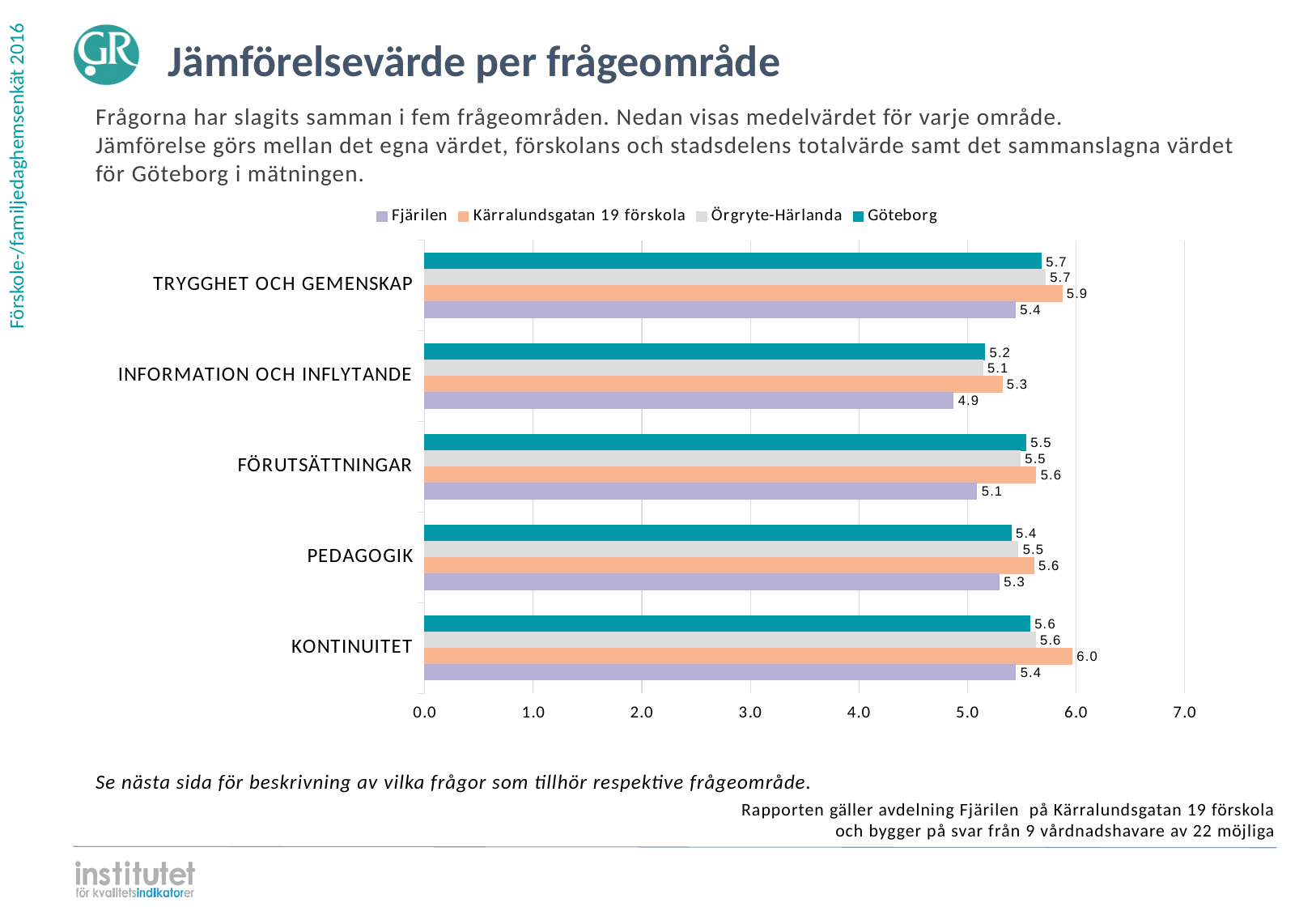
What is the value for Kärralundsgatan 19 förskola in the KONTINUITET category? 6.0 How many categories are shown on the chart? 5 What is the value for Göteborg in the PEDAGOGIK category? 5.4 What is the difference between the Kärralundsgatan 19 förskola value and the Fjärilen value in the TRYGGHET OCH GEMENSKAP category? 0.5 What kind of chart is shown on the slide? Bar chart In which category does Fjärilen have its lowest value? INFORMATION OCH INFLYTANDE How many series does the legend list? 4 In which category does Kärralundsgatan 19 förskola have its highest value? KONTINUITET What is the value for Örgryte-Härlanda in the FÖRUTSÄTTNINGAR category? 5.5 What is the value for Fjärilen in the INFORMATION OCH INFLYTANDE category? 4.9 What is the title of the slide? Jämförelsevärde per frågeområde Which is larger in the PEDAGOGIK category: the value for Fjärilen or the value for Örgryte-Härlanda? Örgryte-Härlanda